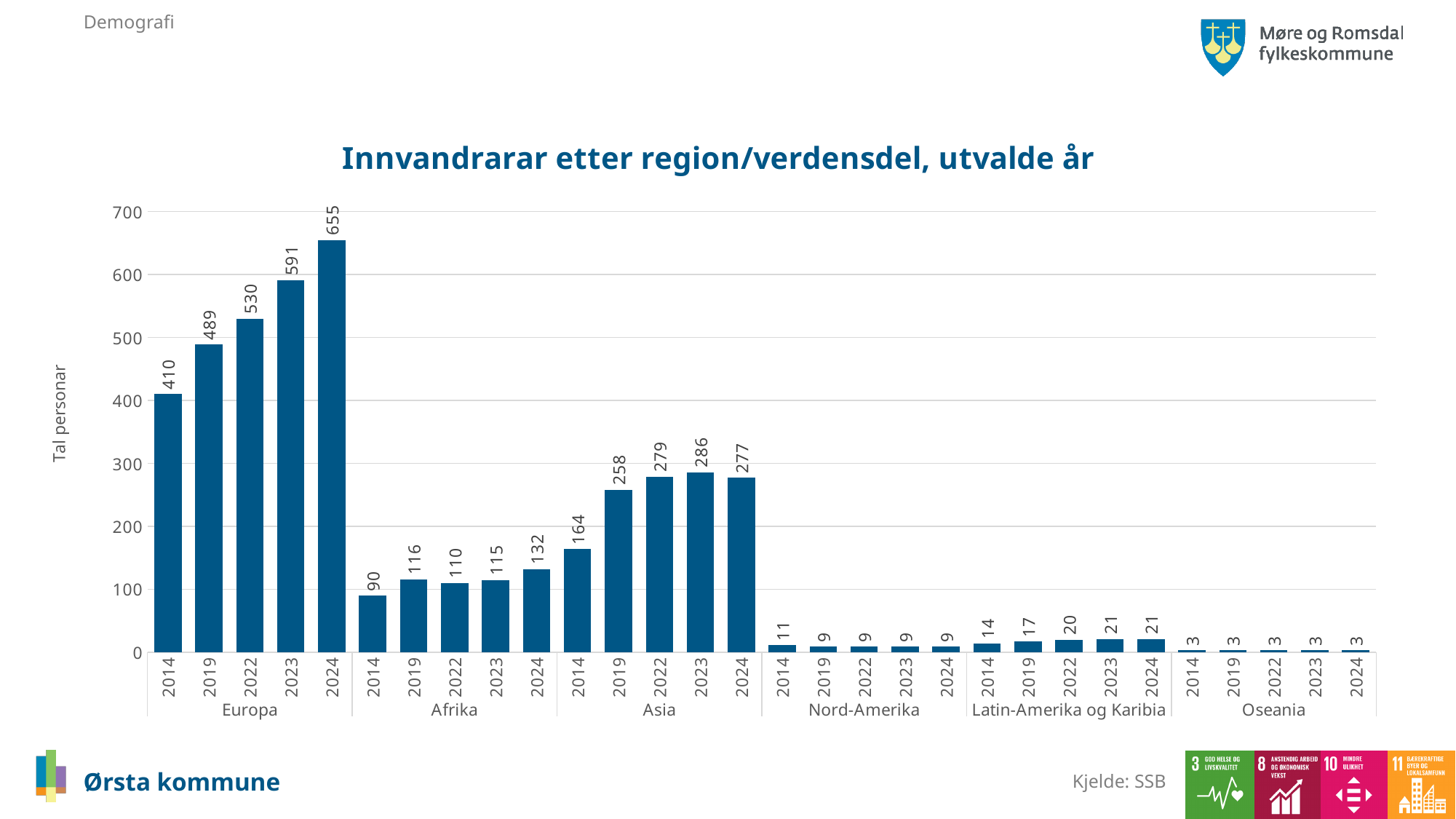
What is the value for Asia in 2019? 258 What is the value for Latin-Amerika og Karibia in 2023? 21 What kind of chart is this? bar chart Which bar has the highest value on the chart? Europa 2024 Which region has the lowest values across all years? Oseania Is the value for Afrika in 2024 greater or less than 100? greater What is the value for Afrika in 2014? 90 Do the Europa values rise or fall from 2014 to 2024? rise What is the difference between the Europa values for 2024 and 2014? 245 What is the value for Europa in 2024? 655 Which is larger, the Asia value for 2023 or the Asia value for 2024? Asia 2023 How many regions are shown on the x axis? 6